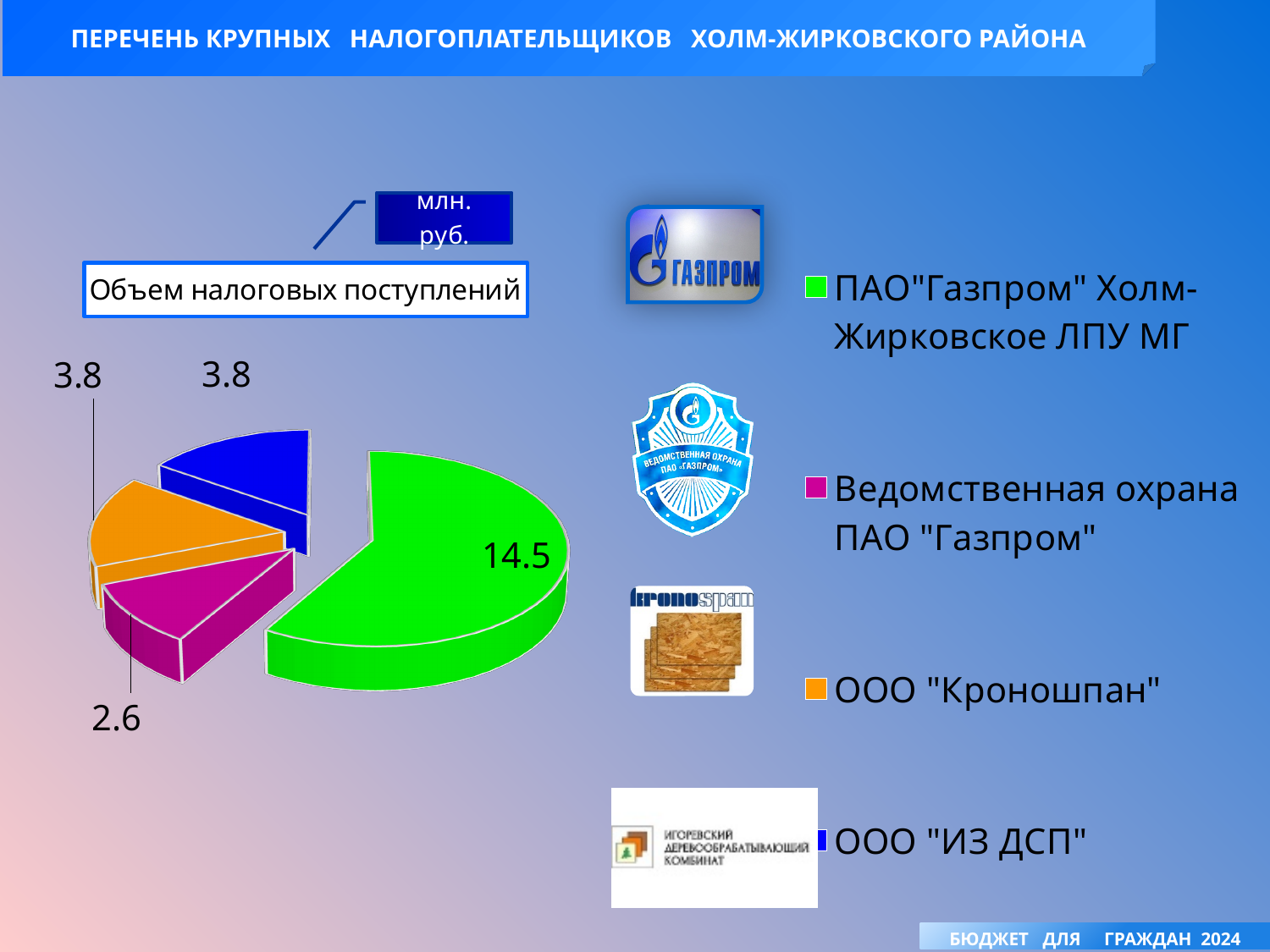
What is the value for ООО "ИЗ ДСП"? 3.8 What is the value for Ведомственная охрана ПАО "Газпром"? 2.6 What is the title of the chart? Объем налоговых поступлений Which is larger, the value for ООО "Кроношпан" or the value for Ведомственная охрана ПАО "Газпром"? ООО "Кроношпан" Which taxpayer has the smallest slice of the pie? Ведомственная охрана ПАО "Газпром" Which taxpayer has the largest slice of the pie? ПАО "Газпром" Холм-Жирковское ЛПУ МГ What is the value for ПАО "Газпром" Холм-Жирковское ЛПУ МГ? 14.5 What is the value for ООО "Кроношпан"? 3.8 What is the difference between the values for ПАО "Газпром" Холм-Жирковское ЛПУ МГ and Ведомственная охрана ПАО "Газпром"? 11.9 What type of chart is shown on the slide? pie chart In what units are the chart values given? млн. руб. How many slices does the pie chart have? 4